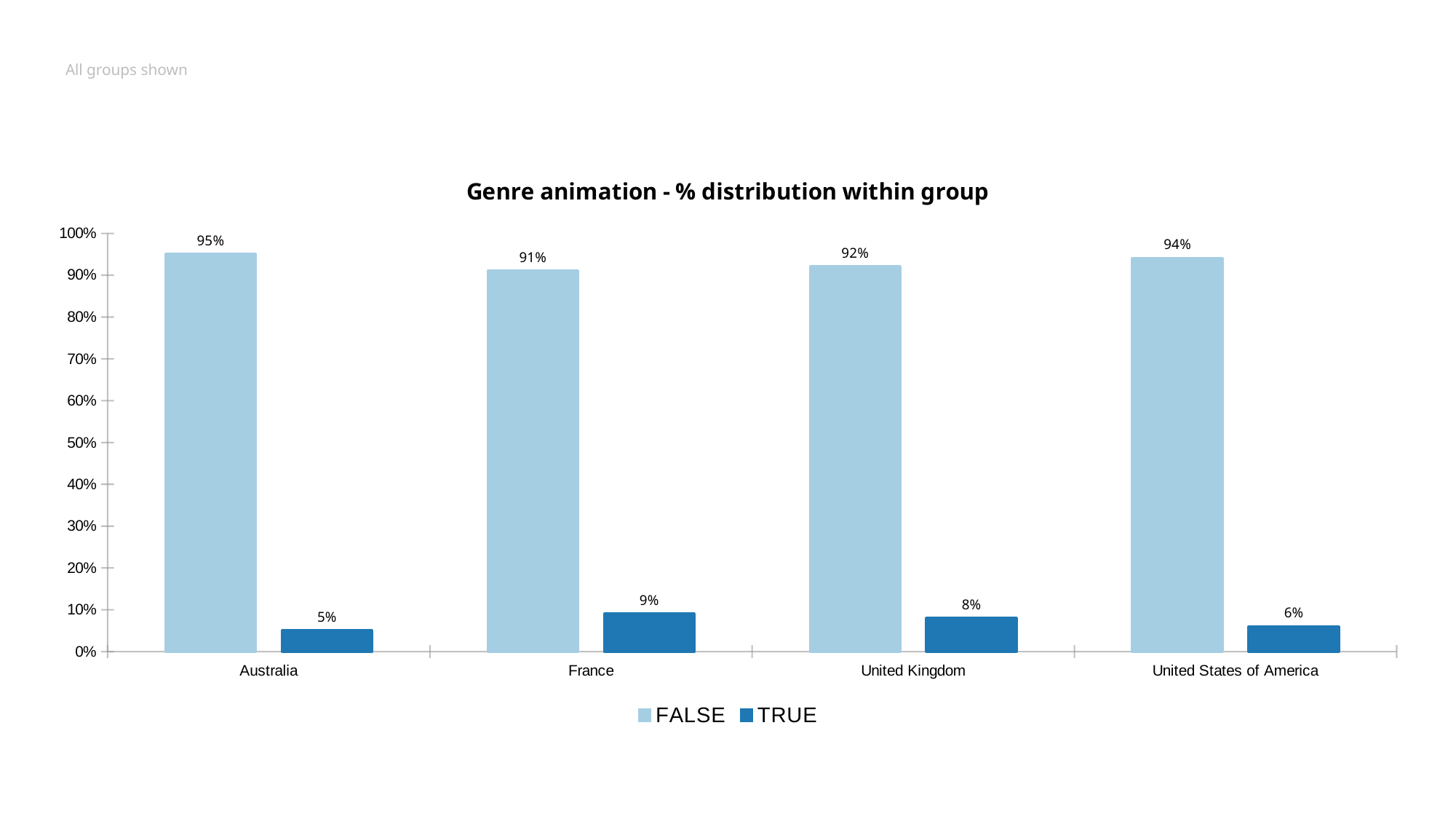
What is the TRUE value for France? 9% How many countries are shown on the x axis? 4 What is the TRUE value for United States of America? 6% How many series does the legend list? 2 Which country has the lowest FALSE value? France What is the FALSE value for United Kingdom? 92% What kind of chart is shown on the slide? bar chart Is the FALSE value for United States of America greater or less than 90%? greater What is the FALSE value for Australia? 95% What is the difference between the FALSE value for Australia and the FALSE value for France? 4% Which country has the highest TRUE value? France Which is larger, the TRUE value for United Kingdom or the TRUE value for Australia? United Kingdom